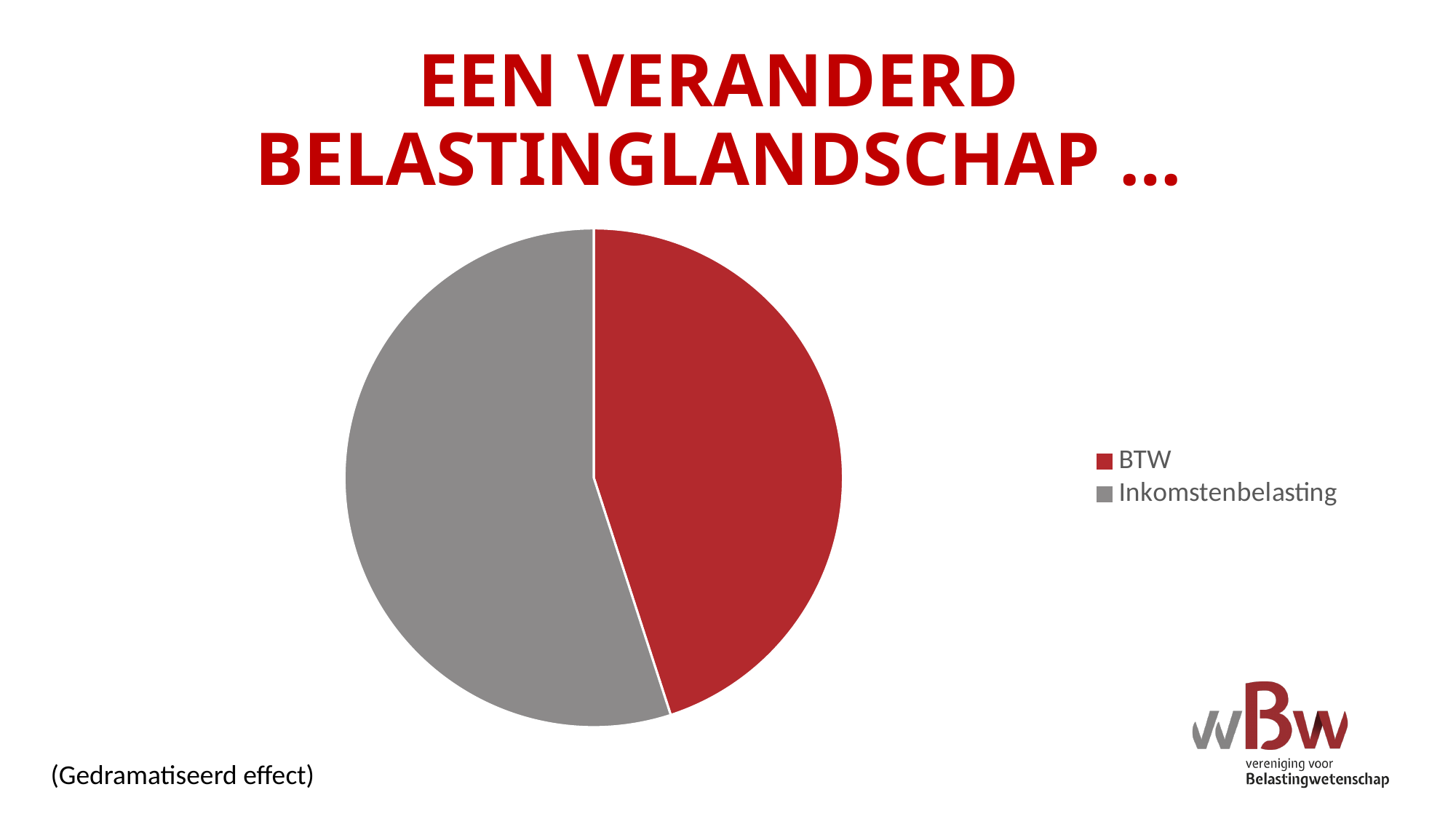
How many entries does the legend of the pie chart list? 2 Which colour represents BTW in the pie chart? red How many slices does the pie chart have? 2 Which colour represents Inkomstenbelasting in the pie chart? grey Which category has the smallest slice in the pie chart? BTW What kind of chart is shown on the slide? pie chart Which slice is larger in the pie chart, BTW or Inkomstenbelasting? Inkomstenbelasting Which category has the largest slice in the pie chart? Inkomstenbelasting